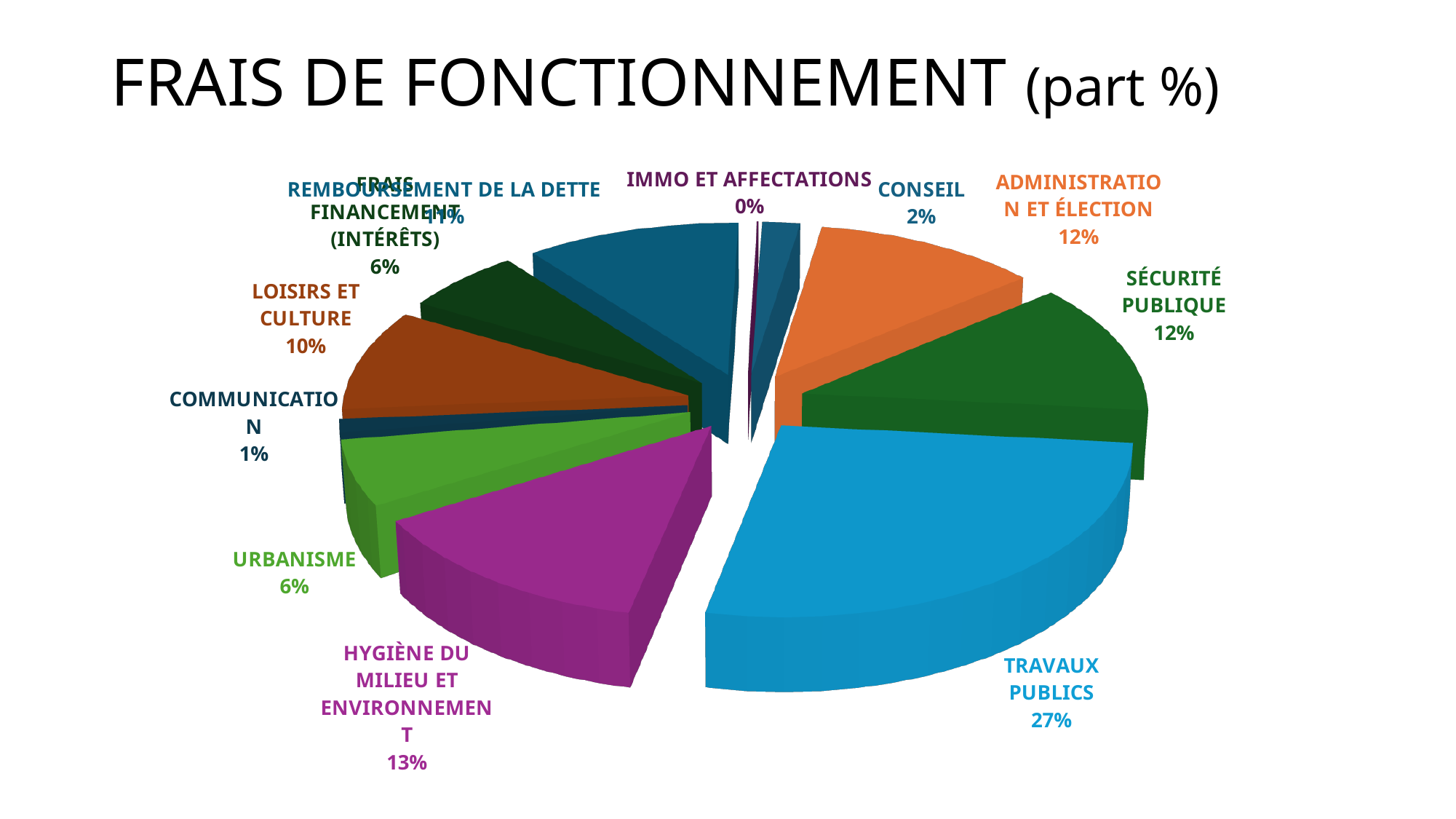
What percentage is shown for HYGIÈNE DU MILIEU ET ENVIRONNEMENT? 13% What percentage is shown for CONSEIL? 2% What is the title of the chart? FRAIS DE FONCTIONNEMENT (part %) What kind of chart is shown on the slide? pie chart Which category has the smallest share of the pie? IMMO ET AFFECTATIONS How many categories are shown in the pie chart? 11 Which has a larger share, URBANISME or COMMUNICATION? URBANISME What share does TRAVAUX PUBLICS have in the pie chart? 27% What is the difference in percentage points between TRAVAUX PUBLICS and HYGIÈNE DU MILIEU ET ENVIRONNEMENT? 14 What percentage is shown for SÉCURITÉ PUBLIQUE? 12% Which category has the largest share of the pie? TRAVAUX PUBLICS What percentage is shown for LOISIRS ET CULTURE? 10%